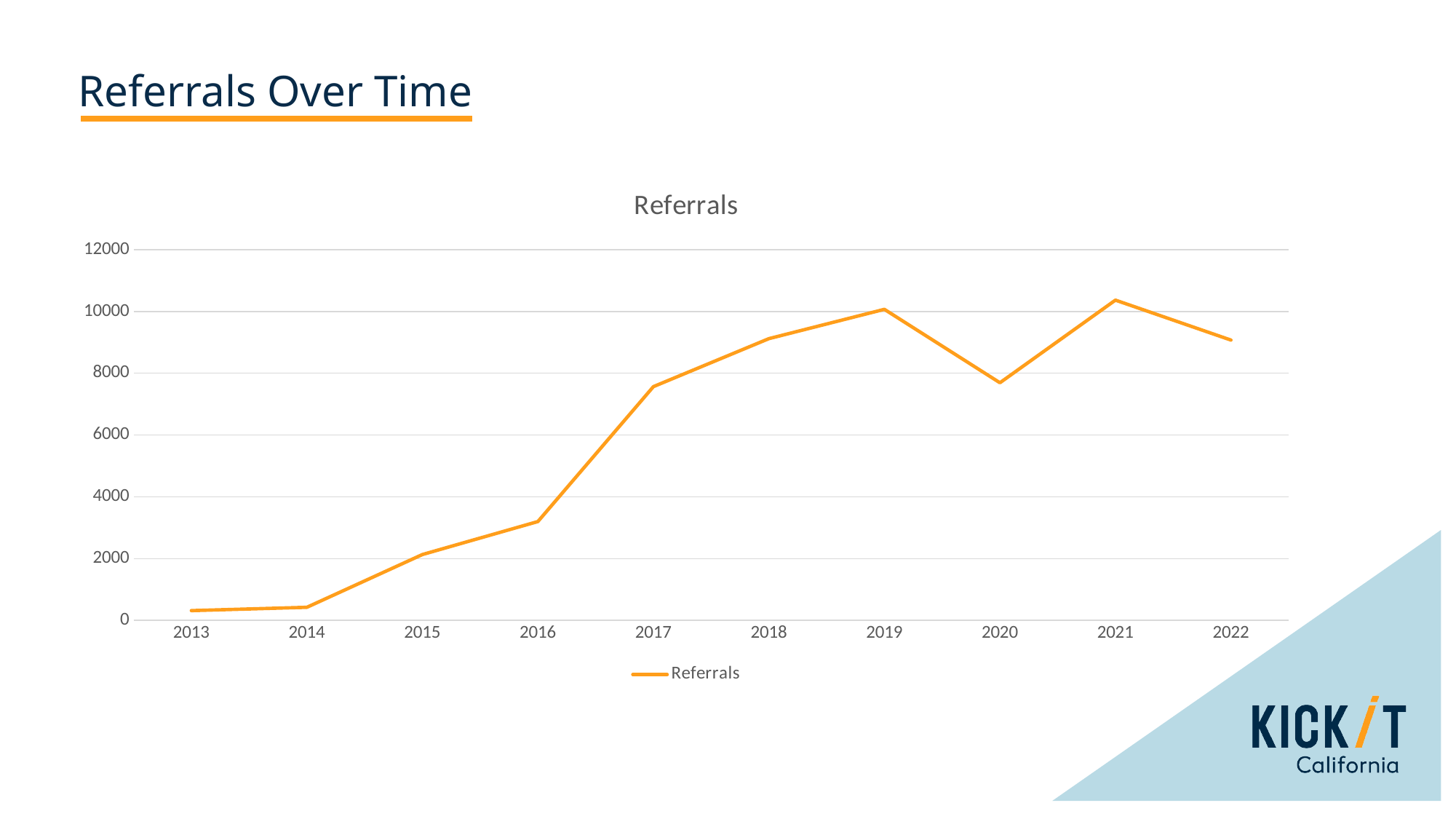
How many years are plotted along the x axis? 10 Is the value for 2022 greater or less than 10000? less What kind of chart is shown on the slide? line chart Is the value for 2017 greater or less than 6000? greater Is the value for 2014 greater or less than 2000? less Which year has more referrals, 2019 or 2020? 2019 Which year has the highest number of referrals? 2021 Which year has the lowest number of referrals? 2013 How many series does the legend list? 1 What is the title of the chart? Referrals Do referrals rise or fall from 2013 to 2019? rise